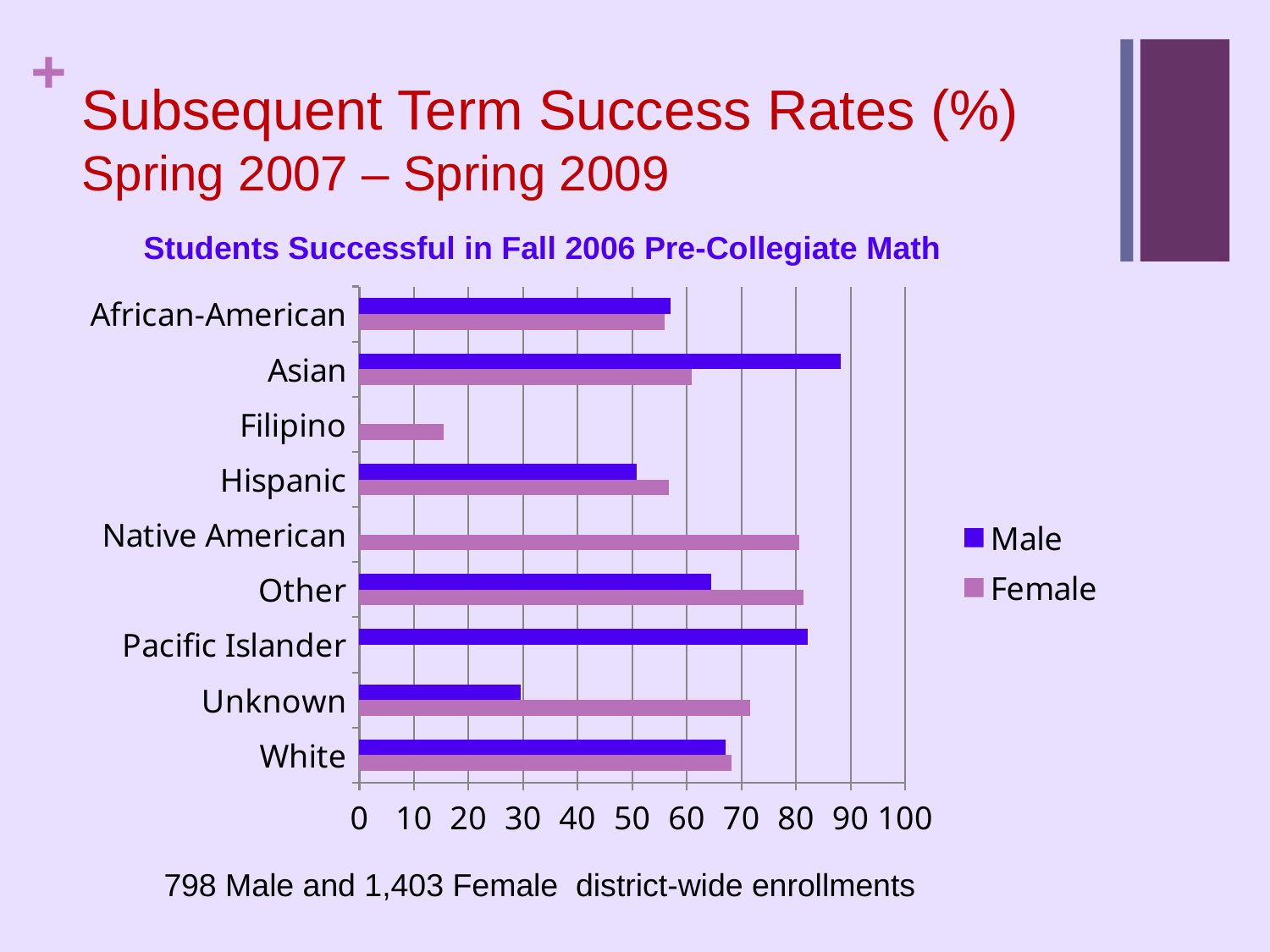
Which category has the highest Male success rate? Asian Is the Male value for Unknown greater or less than 40? less Is the Female value for Filipino greater or less than 20? less For the Unknown category, which is larger, the Male or the Female success rate? Female How many series does the legend list? 2 How many ethnic categories are listed on the chart? 9 Which category has the lowest Male success rate among those with a Male bar? Unknown For the Asian category, which is larger, the Male or the Female success rate? Male What is the title of the chart? Students Successful in Fall 2006 Pre-Collegiate Math Which category has the lowest Female success rate? Filipino What kind of chart is shown on the slide? bar chart Is the Male value for Asian greater or less than 80? greater